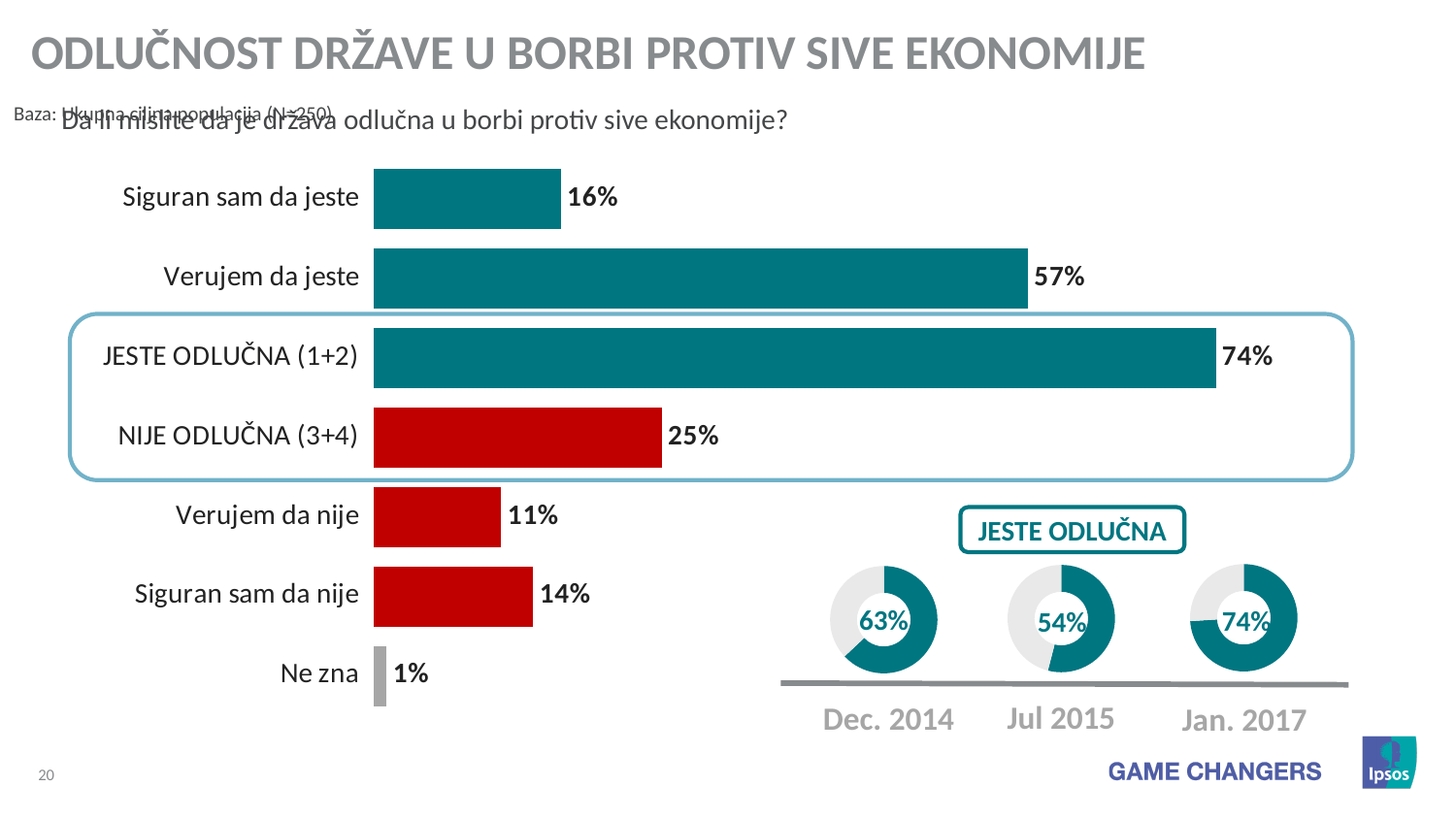
What kind of chart is the main chart on the left of the slide? Bar chart In the horizontal bar chart, what is the value for "Verujem da jeste"? 57% In the "JESTE ODLUČNA" donut charts, which period has the highest value? Jan. 2017 In the "JESTE ODLUČNA" donut charts, what is the value for Jul 2015? 54% In the horizontal bar chart, what is the difference between "JESTE ODLUČNA (1+2)" and "NIJE ODLUČNA (3+4)"? 49% In the horizontal bar chart, what is the value for "Ne zna"? 1% How many categories does the horizontal bar chart show? 7 In the horizontal bar chart, what is the value for "NIJE ODLUČNA (3+4)"? 25% In the horizontal bar chart, which category has the lowest value? Ne zna In the horizontal bar chart, which is larger: "Siguran sam da jeste" or "Siguran sam da nije"? Siguran sam da jeste In the horizontal bar chart, which category has the highest value? JESTE ODLUČNA (1+2) In the "JESTE ODLUČNA" donut charts, what is the difference between Jan. 2017 and Dec. 2014? 11%